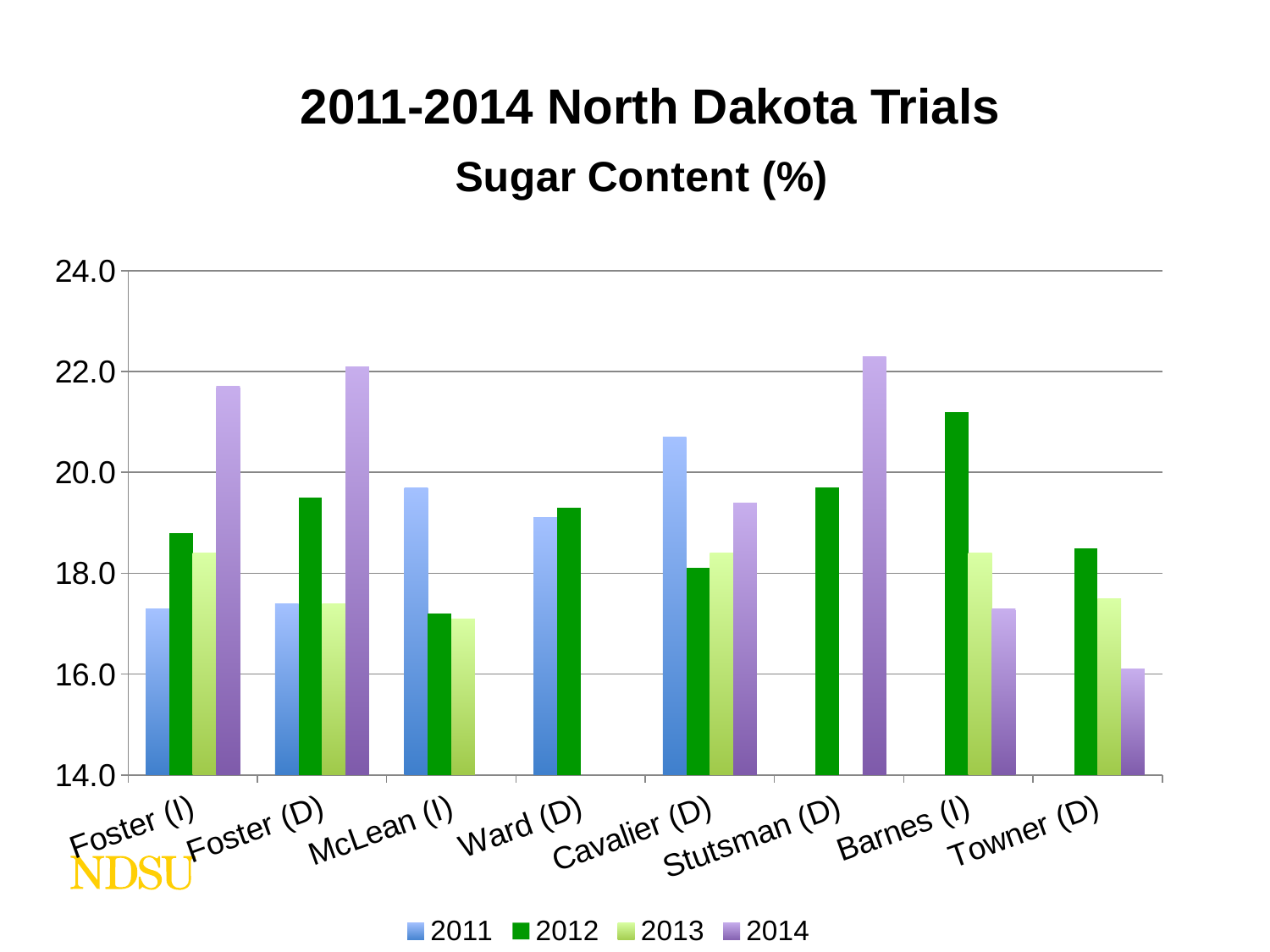
How many trial locations are shown along the x axis? 8 Is the 2014 value for Foster (I) greater or less than 20.0? greater What is the subtitle of the chart? Sugar Content (%) Is the 2014 value for Towner (D) greater or less than 18.0? less For Towner (D), which year has the higher sugar content, 2012 or 2013? 2012 Which location has the lowest 2014 sugar content? Towner (D) What kind of chart is shown on the slide? bar chart Which location has the highest 2012 sugar content? Barnes (I) How many series does the legend list? 4 For Cavalier (D), which year has the higher sugar content, 2011 or 2012? 2011 Is the 2011 value for Cavalier (D) greater or less than 20.0? greater